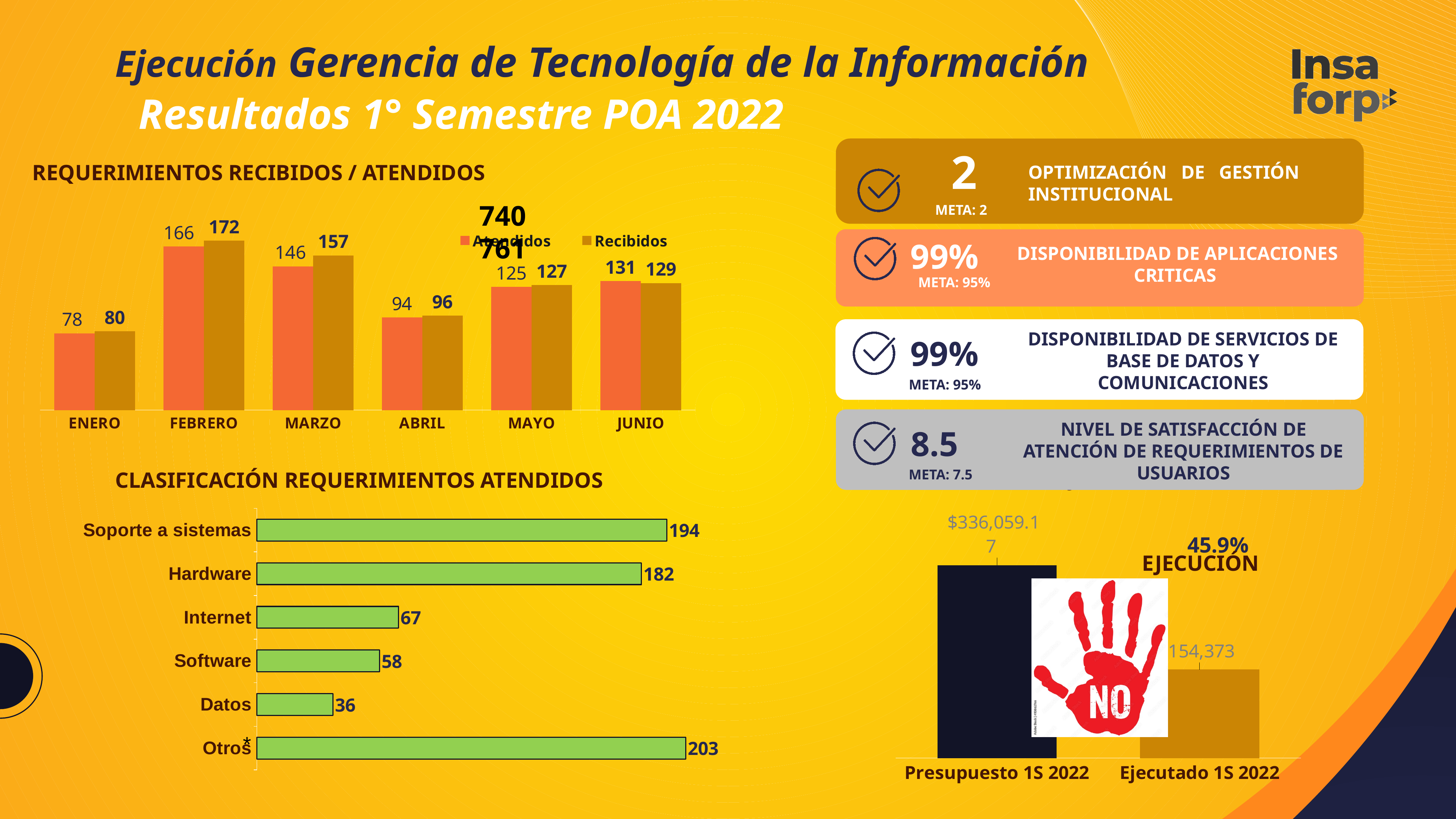
In the budget chart at the bottom right, what is the value for Ejecutado 1S 2022? 154,373 What kind of chart is 'CLASIFICACIÓN REQUERIMIENTOS ATENDIDOS'? bar chart In the 'REQUERIMIENTOS RECIBIDOS / ATENDIDOS' chart, how many series does the legend list? 2 In the 'REQUERIMIENTOS RECIBIDOS / ATENDIDOS' chart, what is the Atendidos value for ABRIL? 94 In the 'REQUERIMIENTOS RECIBIDOS / ATENDIDOS' chart, what is the Recibidos value for FEBRERO? 172 In the 'CLASIFICACIÓN REQUERIMIENTOS ATENDIDOS' chart, what is the value for Hardware? 182 In the 'CLASIFICACIÓN REQUERIMIENTOS ATENDIDOS' chart, which category has the lowest value? Datos In the 'REQUERIMIENTOS RECIBIDOS / ATENDIDOS' chart, what is the difference between Recibidos and Atendidos in MARZO? 11 In the 'REQUERIMIENTOS RECIBIDOS / ATENDIDOS' chart, how many months are shown on the x axis? 6 In the 'CLASIFICACIÓN REQUERIMIENTOS ATENDIDOS' chart, which category has the highest value? Otros In the 'REQUERIMIENTOS RECIBIDOS / ATENDIDOS' chart, is the Atendidos value for JUNIO larger or smaller than the Recibidos value for JUNIO? larger In the 'REQUERIMIENTOS RECIBIDOS / ATENDIDOS' chart, which month has the lowest Atendidos value? ENERO